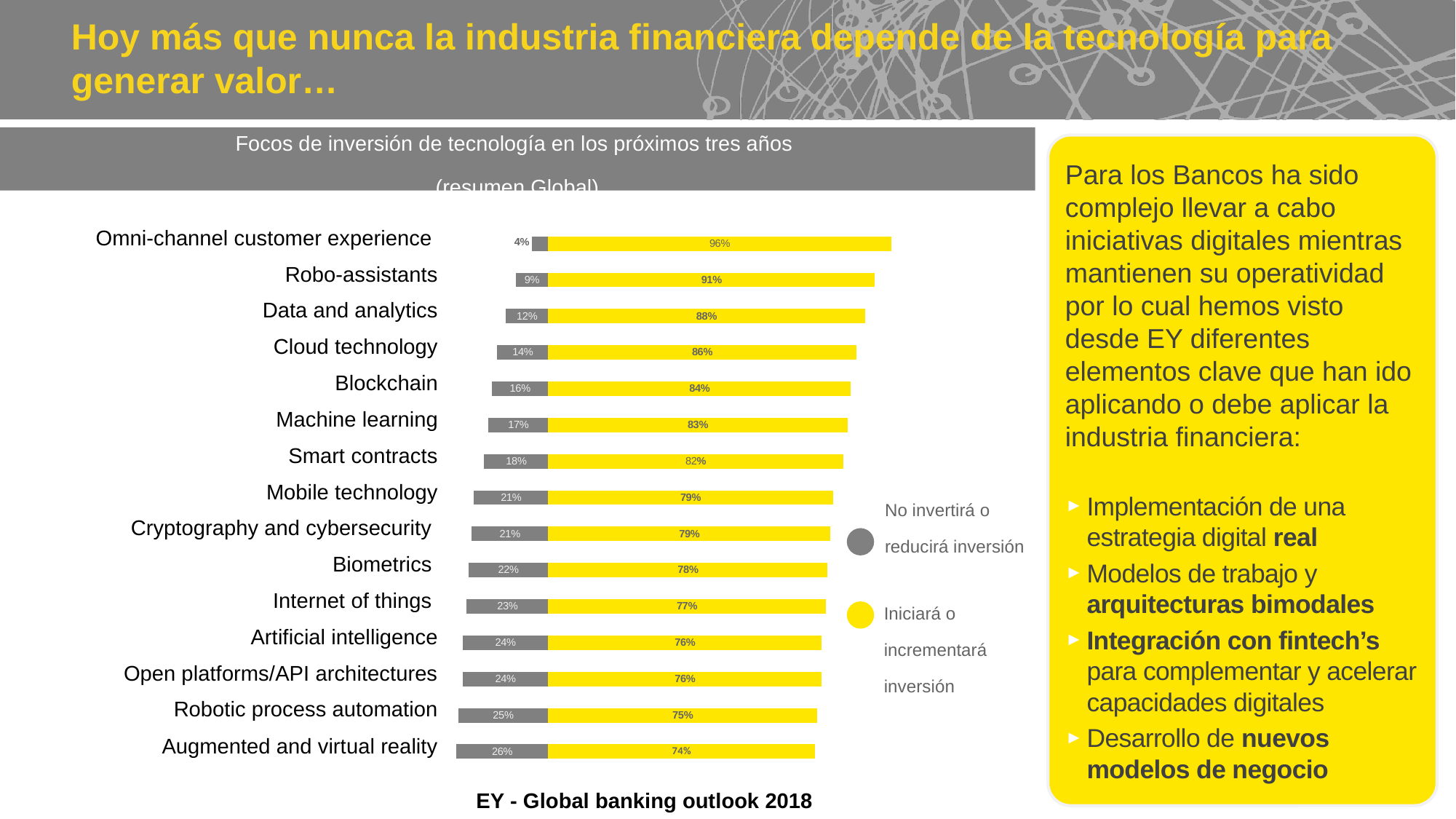
What is the "Iniciará o incrementará inversión" value for Biometrics? 78% What is the difference between the "Iniciará o incrementará inversión" values for Robo-assistants and Cloud technology? 5% Which category has the lowest "Iniciará o incrementará inversión" percentage? Augmented and virtual reality How many categories are shown in the chart? 15 Which category has the highest "Iniciará o incrementará inversión" percentage? Omni-channel customer experience What kind of chart is shown on the slide? Stacked bar chart Which has a larger "No invertirá o reducirá inversión" share: Machine learning or Internet of things? Internet of things How many series does the legend list? 2 What is the total of the two segments for the Mobile technology bar? 100% What percentage will not invest or will reduce investment ("No invertirá o reducirá inversión") in Blockchain? 16% Which colour represents "Iniciará o incrementará inversión" in the chart? Yellow What percentage of respondents will start or increase investment ("Iniciará o incrementará inversión") in Omni-channel customer experience? 96%